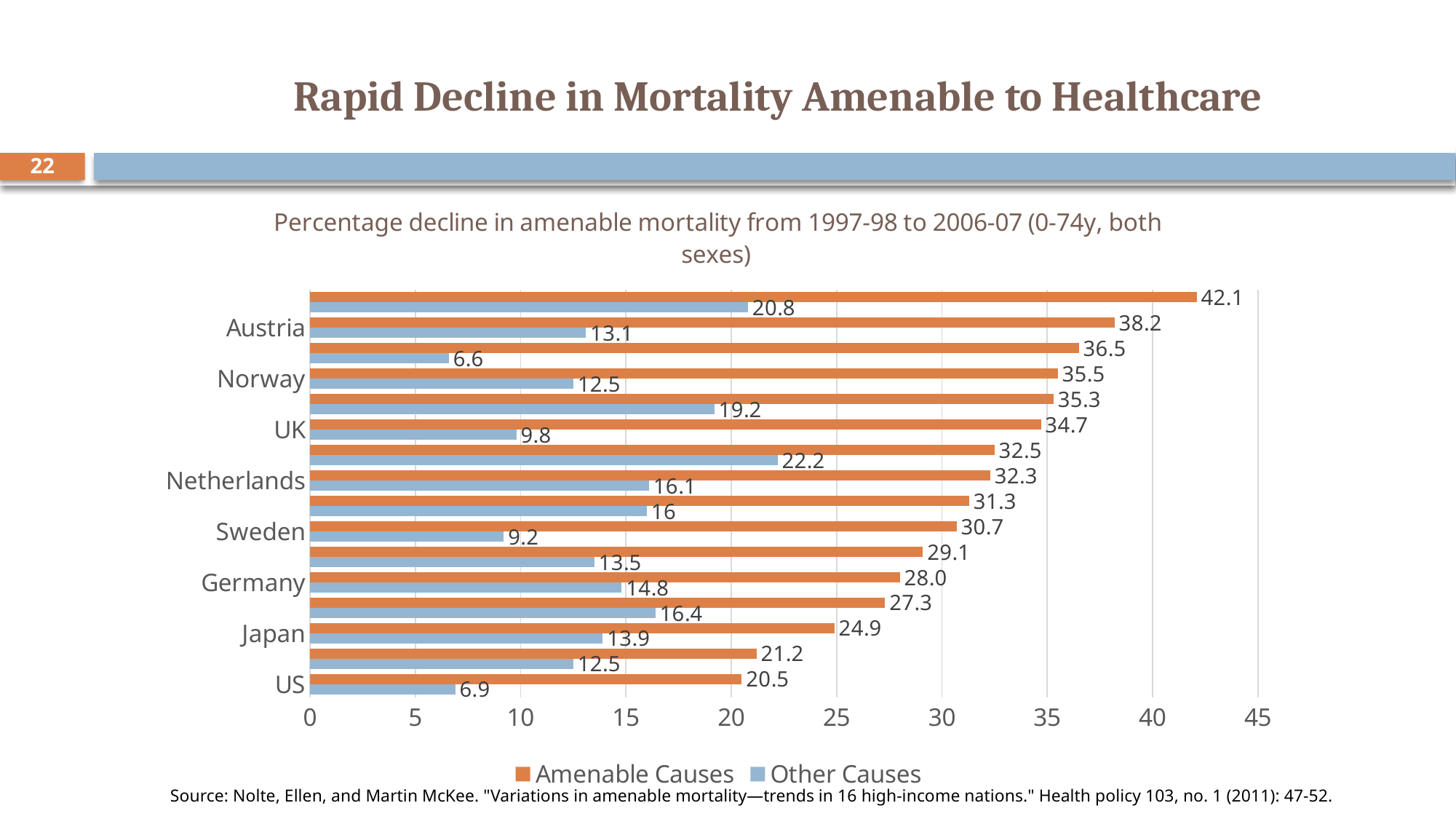
What is the Amenable Causes value for Japan? 24.9 What is the difference between the Amenable Causes and Other Causes values for Germany? 13.2 What is the Amenable Causes value for the UK? 34.7 Which is larger, the Other Causes value for Netherlands or for Norway? Netherlands What kind of chart is shown on the slide? Bar chart What is the Amenable Causes value for the US? 20.5 How many series does the legend list? 2 What is the largest Amenable Causes value shown on the chart? 42.1 What is the Other Causes value for Sweden? 9.2 What is the Other Causes value for Austria? 13.1 What colour are the Amenable Causes bars? Orange Which labeled country has the lowest Amenable Causes value? US